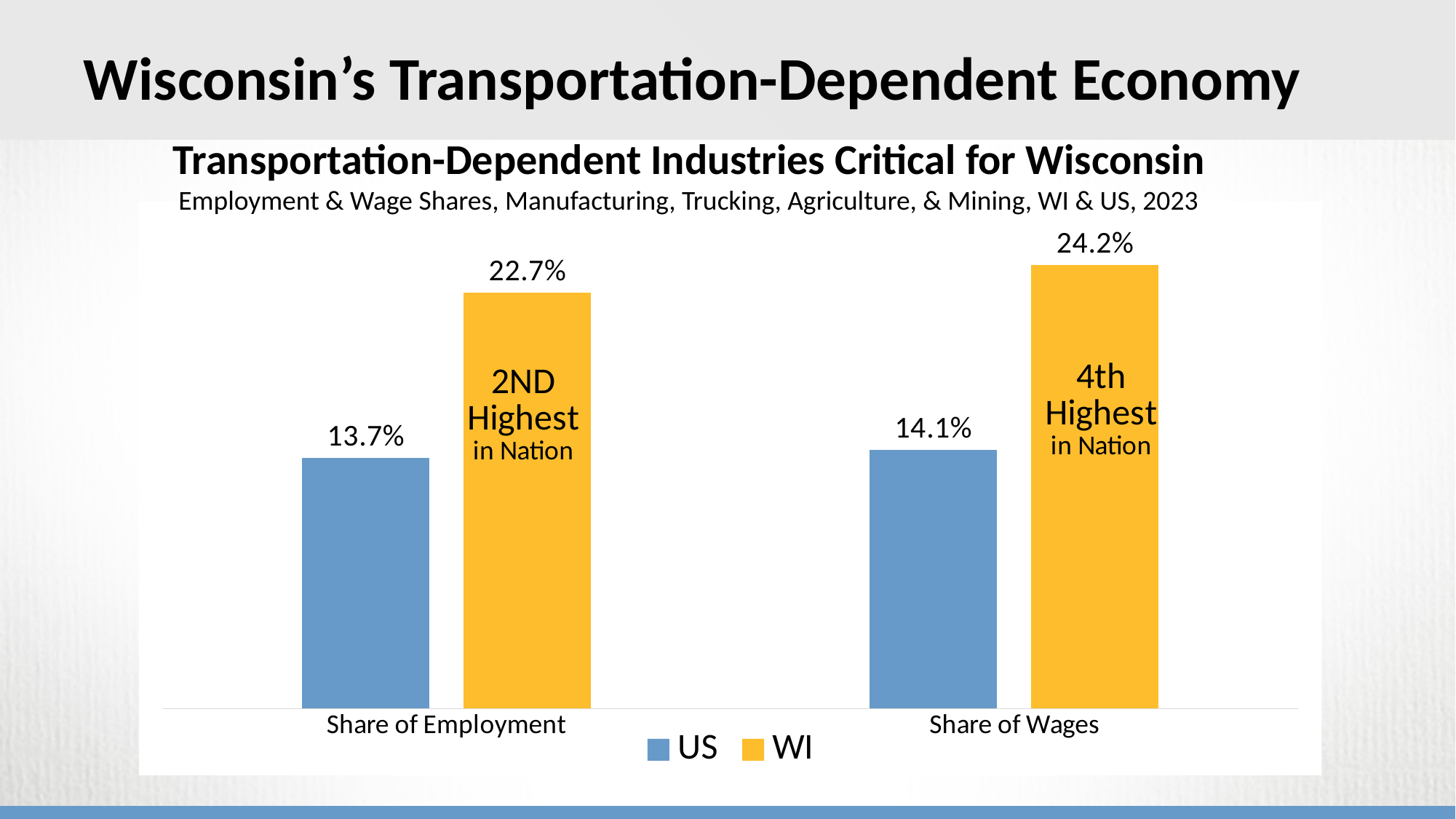
Which bar has the highest value on the chart? WI, Share of Wages What is the US value for Share of Employment? 13.7% What is the US value for Share of Wages? 14.1% Which bar has the lowest value on the chart? US, Share of Employment How many series does the legend list? 2 How many categories are shown on the x axis? 2 Which is larger for Share of Wages, the US value or the WI value? WI What is the WI value for Share of Employment? 22.7% What is the difference between the WI and US values for Share of Wages? 10.1% What kind of chart is shown on the slide? Bar chart What is the WI value for Share of Wages? 24.2% What is the difference between the WI and US values for Share of Employment? 9.0%